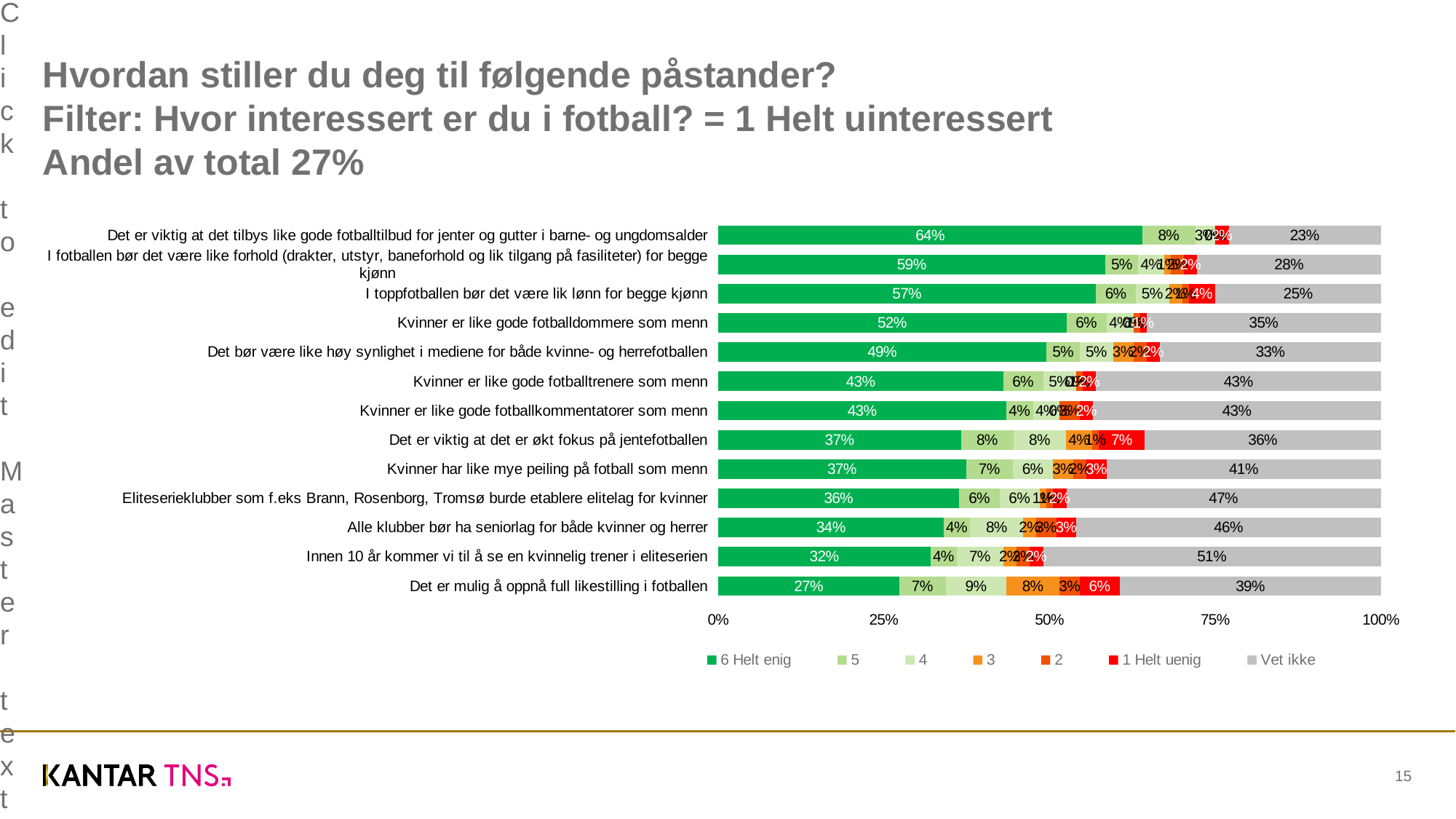
What kind of chart is shown on the slide? Stacked bar chart What is the "1 Helt uenig" share for "Det er mulig å oppnå full likestilling i fotballen"? 6% Which has a larger "Vet ikke" share: "Kvinner er like gode fotballdommere som menn" or "Det bør være like høy synlighet i mediene for både kvinne- og herrefotballen"? Kvinner er like gode fotballdommere som menn What percentage answered "6 Helt enig" to "Det er viktig at det tilbys like gode fotballtilbud for jenter og gutter i barne- og ungdomsalder"? 64% What is the "Vet ikke" share for "Eliteserieklubber som f.eks Brann, Rosenborg, Tromsø burde etablere elitelag for kvinner"? 47% Which statement has the highest "6 Helt enig" share? Det er viktig at det tilbys like gode fotballtilbud for jenter og gutter i barne- og ungdomsalder How many series does the legend list? 7 Which statement has the lowest "6 Helt enig" share? Det er mulig å oppnå full likestilling i fotballen What is the difference in percentage points between the highest and lowest "6 Helt enig" shares (64% and 27%)? 37 percentage points What is the "Vet ikke" share for "Innen 10 år kommer vi til å se en kvinnelig trener i eliteserien"? 51% How many statements are shown in the chart? 13 Which statement has the highest "Vet ikke" share? Innen 10 år kommer vi til å se en kvinnelig trener i eliteserien